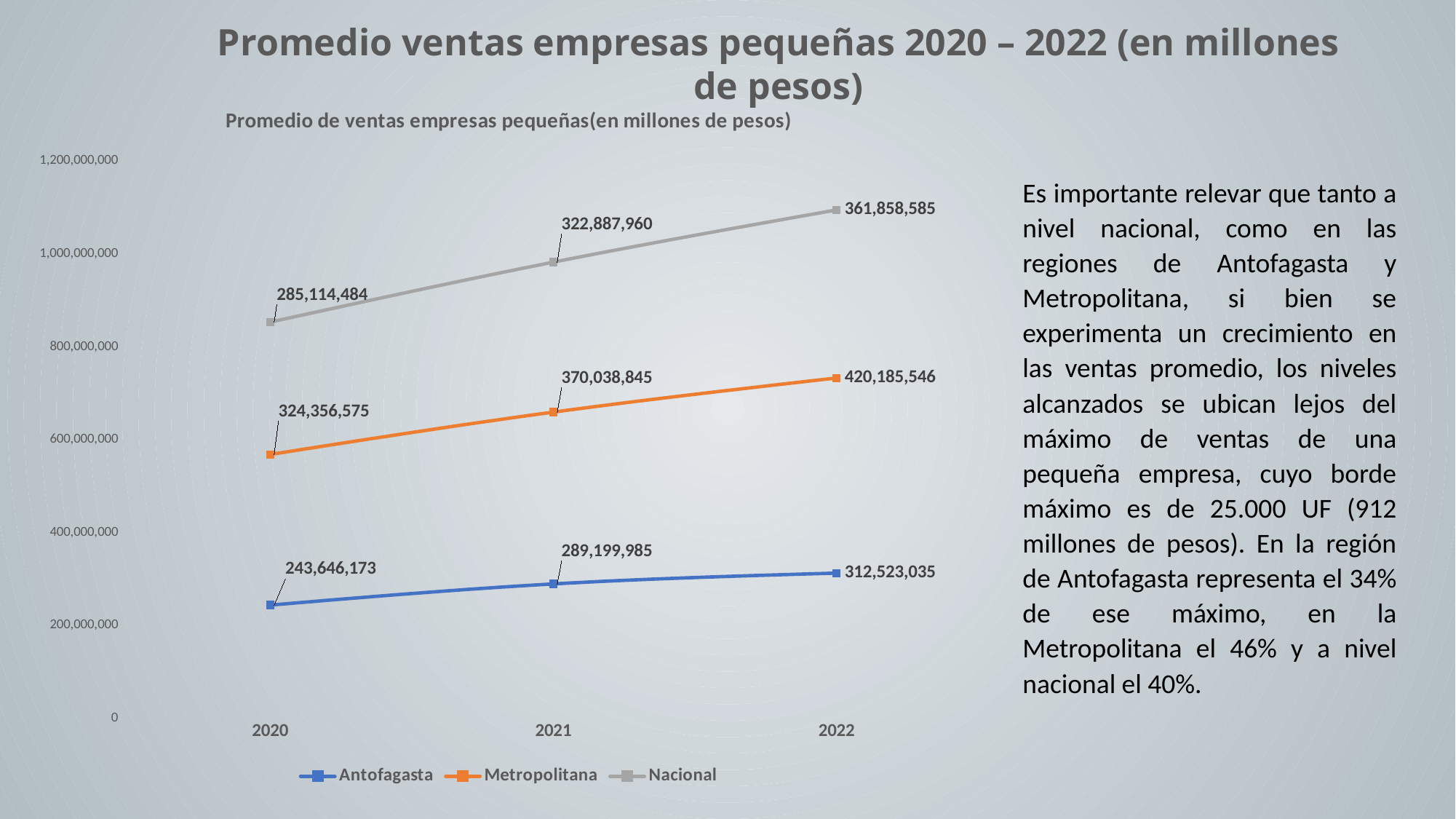
What type of chart is shown on the slide? Line chart What is the value for Antofagasta in 2022? 312,523,035 What is the value for Antofagasta in 2020? 243,646,173 What is the difference between the Metropolitana values for 2022 and 2020? 95,828,971 Do the Antofagasta values rise or fall from 2020 to 2022? Rise According to the data labels, which is larger in 2021: Metropolitana or Nacional? Metropolitana How many series does the legend list? 3 In which year is the Nacional value highest? 2022 What is the value for Nacional in 2021? 322,887,960 What is the value for Metropolitana in 2022? 420,185,546 How many years are plotted along the x axis? 3 In which year is the Metropolitana value lowest? 2020